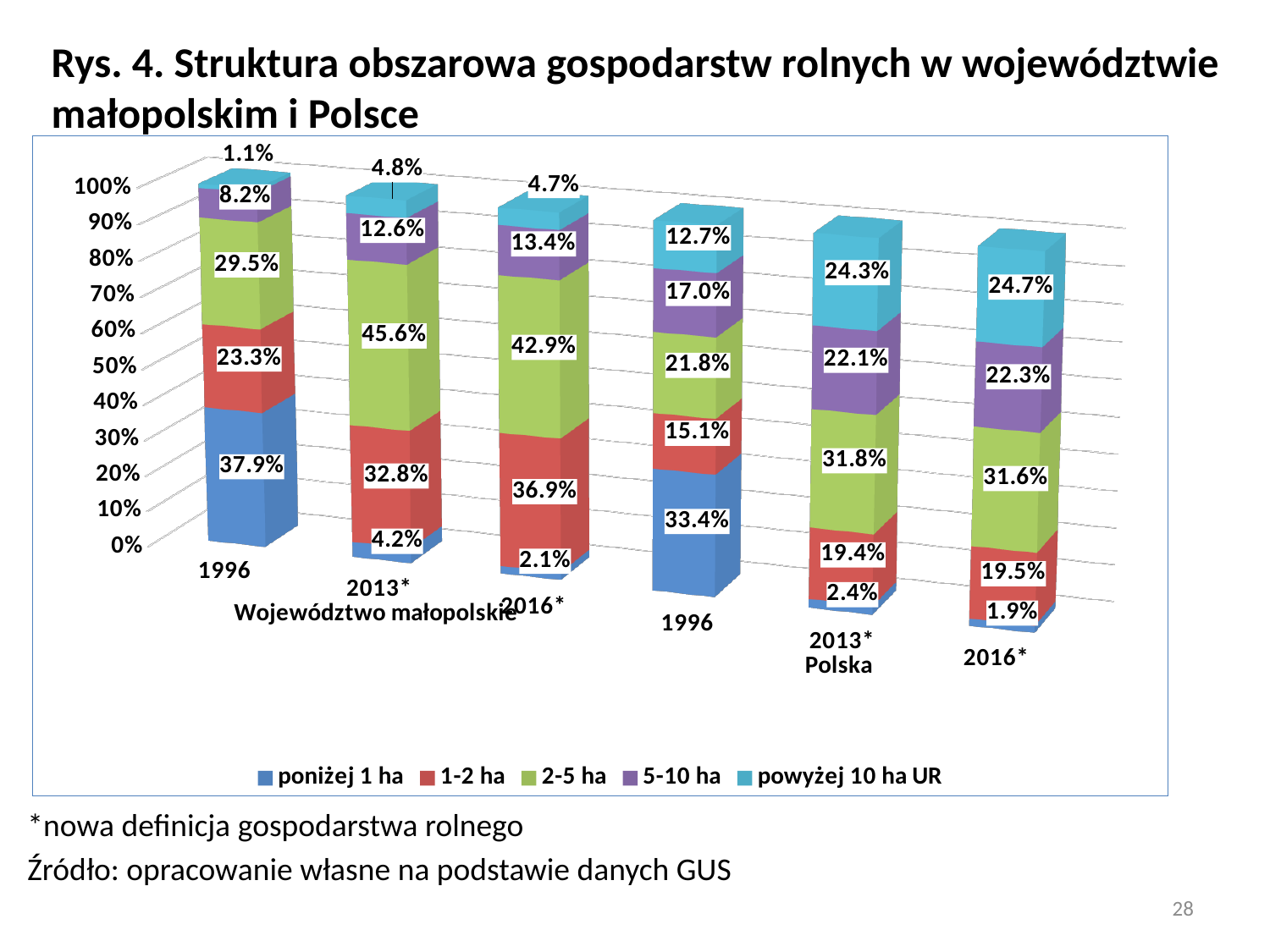
Which bar has the highest share of 2-5 ha farms? Województwo małopolskie 2013* What is the share of 5-10 ha farms in Polska in 1996? 17.0% What is the difference between the share of 1-2 ha farms in Województwo małopolskie in 2016* and in Polska in 2016*? 17.4 percentage points What is the share of farms below 1 ha (poniżej 1 ha) in Województwo małopolskie in 1996? 37.9% How many series does the legend list? 5 How many bars are plotted in the chart? 6 What is the share of farms above 10 ha (powyżej 10 ha UR) in Polska in 2016*? 24.7% Which bar has the lowest share of farms above 10 ha (powyżej 10 ha UR)? Województwo małopolskie 1996 What is the share of 2-5 ha farms in Województwo małopolskie in 2013*? 45.6% Does the share of farms below 1 ha in Województwo małopolskie rise or fall from 1996 to 2016*? fall What type of chart is shown on the slide? stacked bar chart Which is larger: the share of 5-10 ha farms in Polska in 2013* or in Województwo małopolskie in 2013*? Polska 2013*